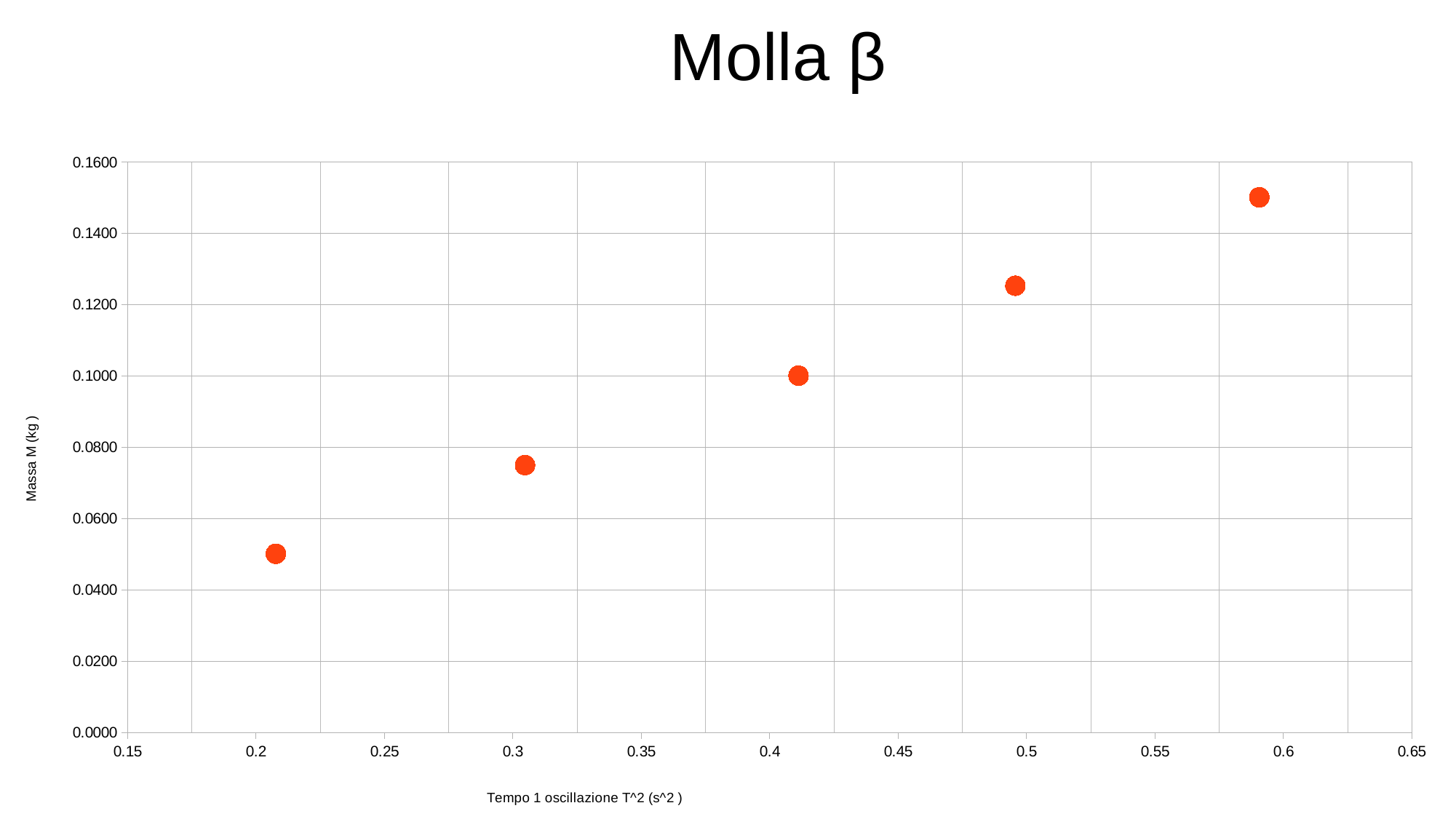
Is the mass value of the rightmost point (near T^2 = 0.6) greater or less than 0.1400? greater Which point has the highest mass value, the leftmost point or the rightmost point? the rightmost point Which point has the lowest mass value, the leftmost point or the rightmost point? the leftmost point What is the title of the chart? Molla β How many data points are plotted on the chart? 5 Is the mass value of the point near T^2 = 0.5 greater or less than 0.1200? greater Is the mass value of the leftmost point (near T^2 = 0.2) greater or less than 0.0600? less Do the plotted mass values rise or fall as T^2 increases along the x axis? rise Is the mass value of the point near T^2 = 0.3 higher or lower than that of the point near T^2 = 0.4? lower What kind of chart is shown on the slide? scatter chart What is the label of the vertical axis? Massa M (kg )